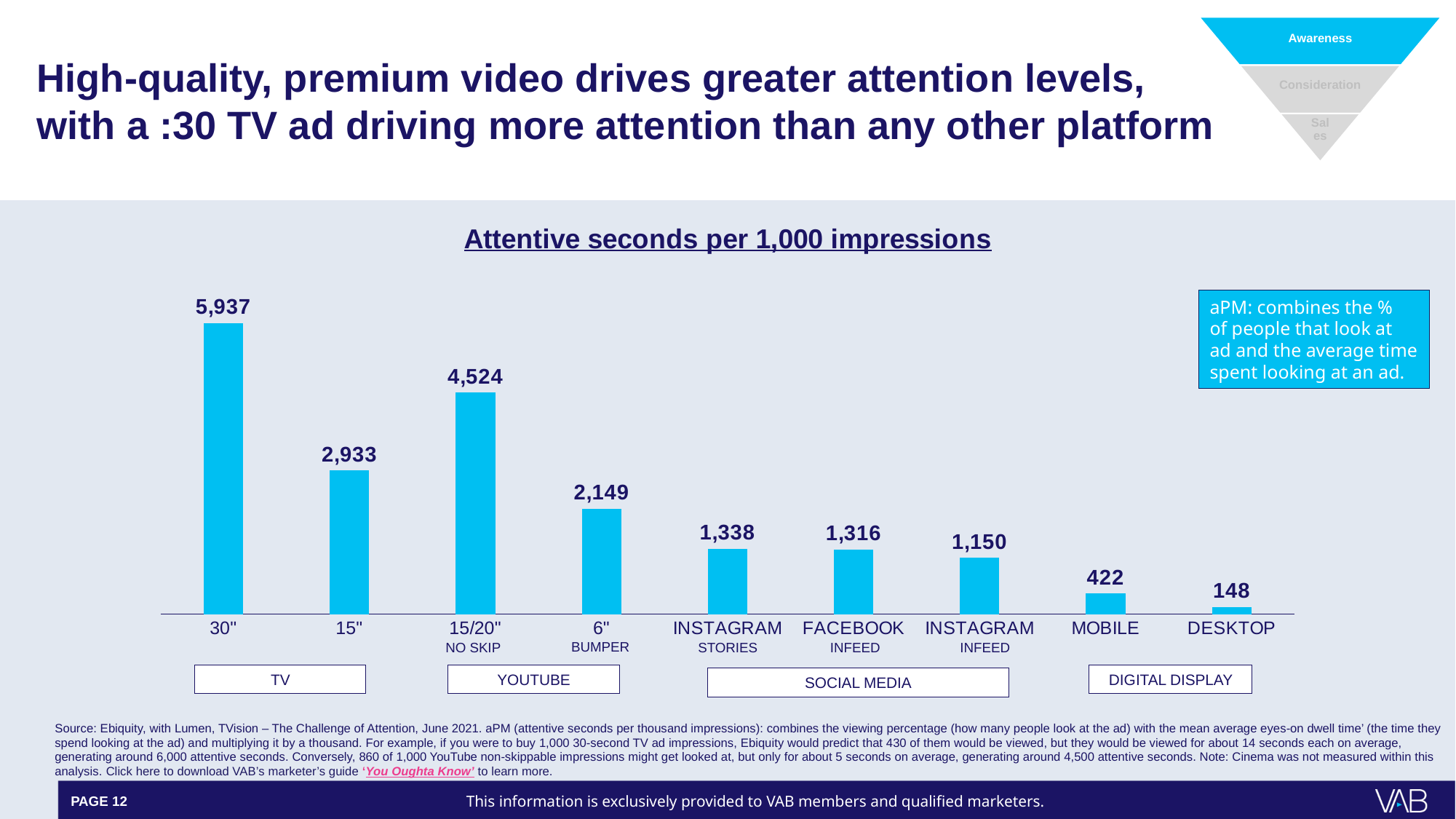
What is the difference between the 30" TV ad and the 15" TV ad values? 3,004 What is the value for Facebook Infeed? 1,316 What is the difference between Mobile and Desktop values? 274 Which category has the lowest attentive seconds per 1,000 impressions? Desktop What is the value for YouTube 15/20" No Skip? 4,524 What kind of chart is shown on the slide? Bar chart Which is larger, Instagram Stories or Instagram Infeed? Instagram Stories Which category has the highest attentive seconds per 1,000 impressions? 30" (TV) What is the value for Desktop digital display? 148 How many categories are plotted in the chart? 9 What is the value for the 30" TV ad in the Attentive seconds per 1,000 impressions chart? 5,937 What is the title of the chart? Attentive seconds per 1,000 impressions